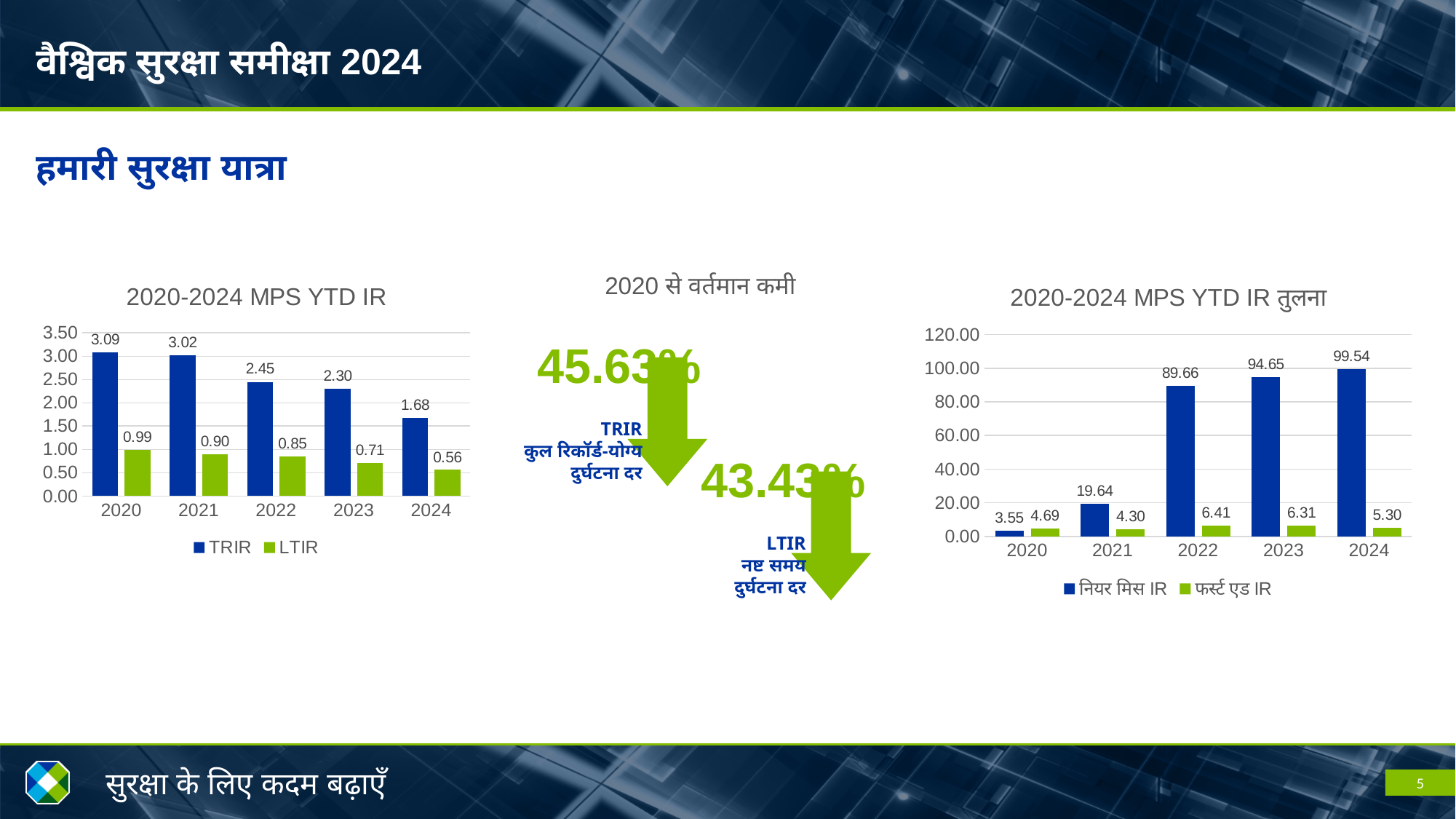
In the '2020-2024 MPS YTD IR तुलना' chart, which is larger in 2020: नियर मिस IR or फर्स्ट एड IR? फर्स्ट एड IR In the '2020-2024 MPS YTD IR' chart, does TRIR rise or fall from 2020 to 2024? fall In the '2020-2024 MPS YTD IR' chart, which year has the highest TRIR? 2020 In the '2020-2024 MPS YTD IR तुलना' chart, what is the नियर मिस IR value for 2023? 94.65 In the '2020-2024 MPS YTD IR' chart, which year has the lowest LTIR? 2024 In the '2020-2024 MPS YTD IR तुलना' chart, which year has the highest नियर मिस IR? 2024 In the '2020-2024 MPS YTD IR' chart, what is the TRIR value for 2022? 2.45 In the '2020-2024 MPS YTD IR' chart, what is the difference between the TRIR values for 2020 and 2024? 1.41 In the '2020-2024 MPS YTD IR तुलना' chart, what is the फर्स्ट एड IR value for 2021? 4.30 What kind of chart is the '2020-2024 MPS YTD IR तुलना' chart? bar chart In the '2020-2024 MPS YTD IR' chart, how many series does the legend list? 2 In the '2020-2024 MPS YTD IR' chart, what is the LTIR value for 2024? 0.56